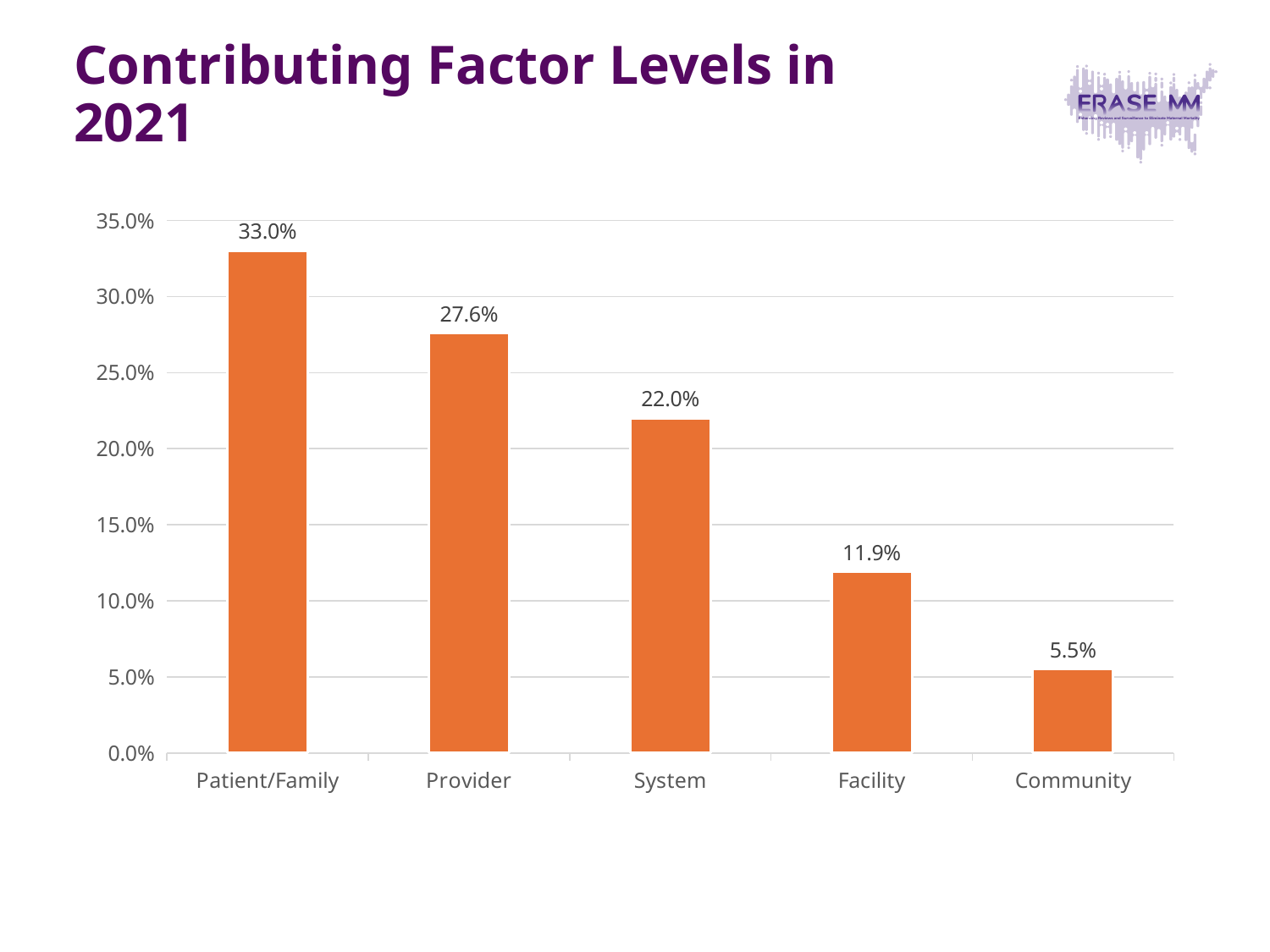
How many categories are shown on the x axis? 5 What kind of chart is shown on the slide? Bar chart What is the value for Patient/Family? 33.0% Is the value for System greater or less than 20.0%? greater What is the difference between the values for Patient/Family and Provider? 5.4% What is the value for Community? 5.5% Which category has the lowest value? Community Which category has the highest value? Patient/Family What is the difference between the values for System and Facility? 10.1% What is the value for Facility? 11.9% Which is larger, the value for System or the value for Facility? System What is the value for Provider? 27.6%